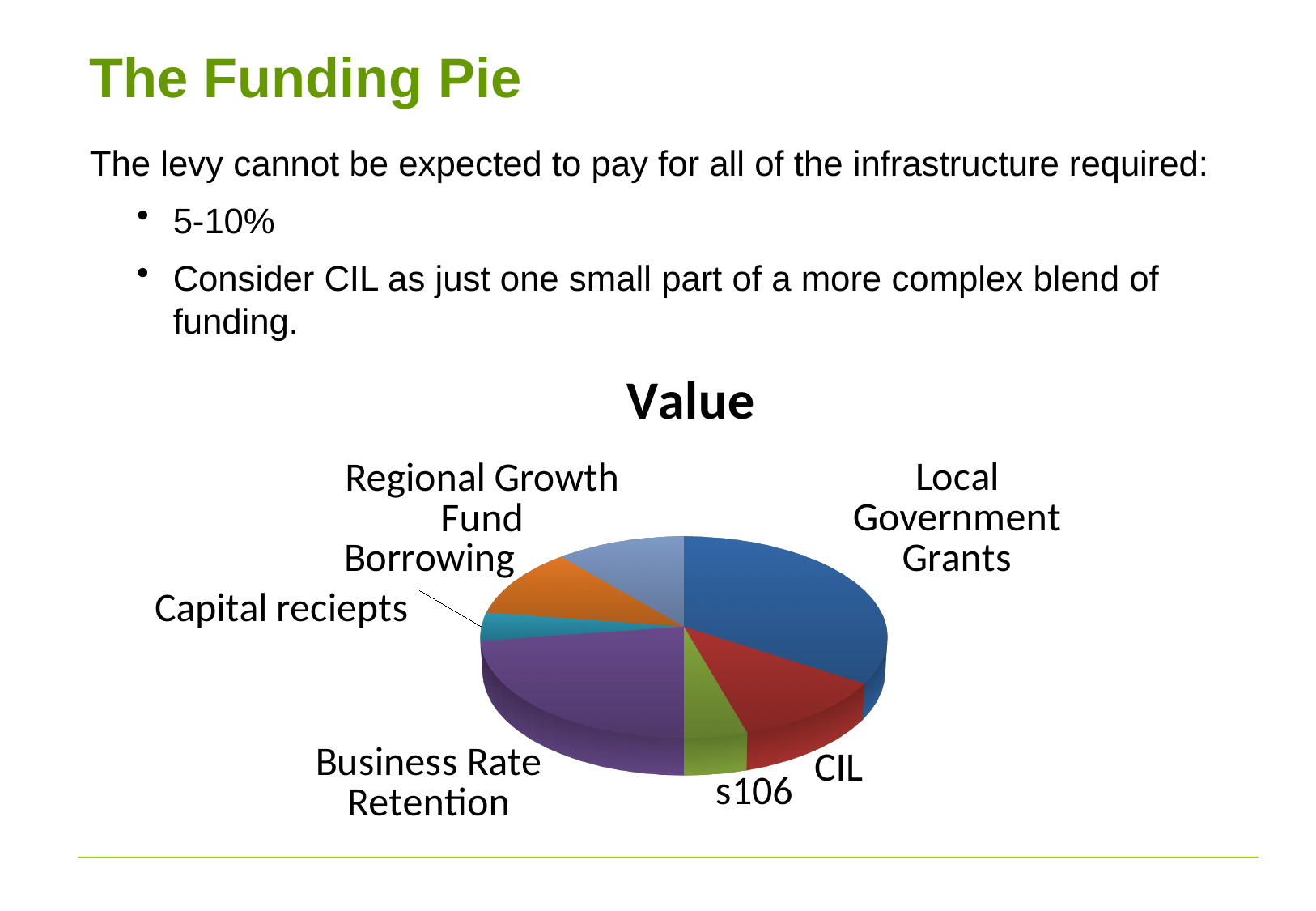
Which slice is larger, Local Government Grants or s106? Local Government Grants Which slice is larger, CIL or s106? CIL Which slice is larger, Borrowing or Capital reciepts? Borrowing Which funding source has the largest slice of the pie? Local Government Grants What is the title of the chart? Value How many slices does the pie chart have? 7 What colour is the Local Government Grants slice? blue What kind of chart is shown on the slide? pie chart